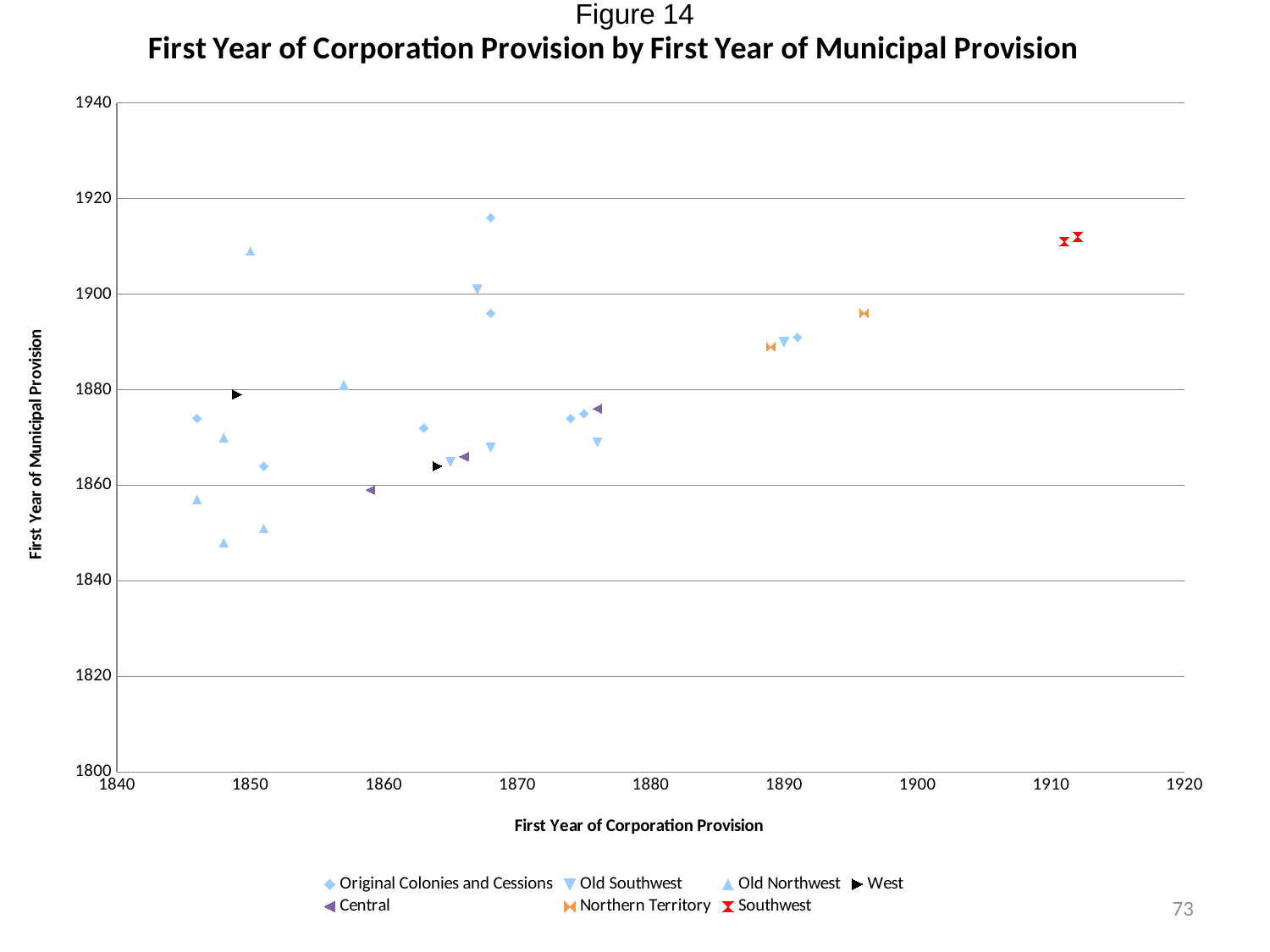
Which series has the points with the highest First Year of Corporation Provision (furthest right)? Southwest What kind of chart is shown on the slide? Scatter chart Is the First Year of Municipal Provision for the Old Northwest point plotted near 1850 on the x axis greater or less than 1900? greater How many Central points are plotted on the chart? 3 How many series does the legend list? 7 What is the title of the vertical axis? First Year of Municipal Provision Overall, do the First Year of Municipal Provision values tend to rise or fall as the First Year of Corporation Provision increases? rise Are the First Year of Municipal Provision values for the Northern Territory points greater or less than 1900? less How many Southwest points are plotted on the chart? 2 What is the title of the chart? First Year of Corporation Provision by First Year of Municipal Provision Are the First Year of Municipal Provision values for the Southwest points greater or less than 1900? greater